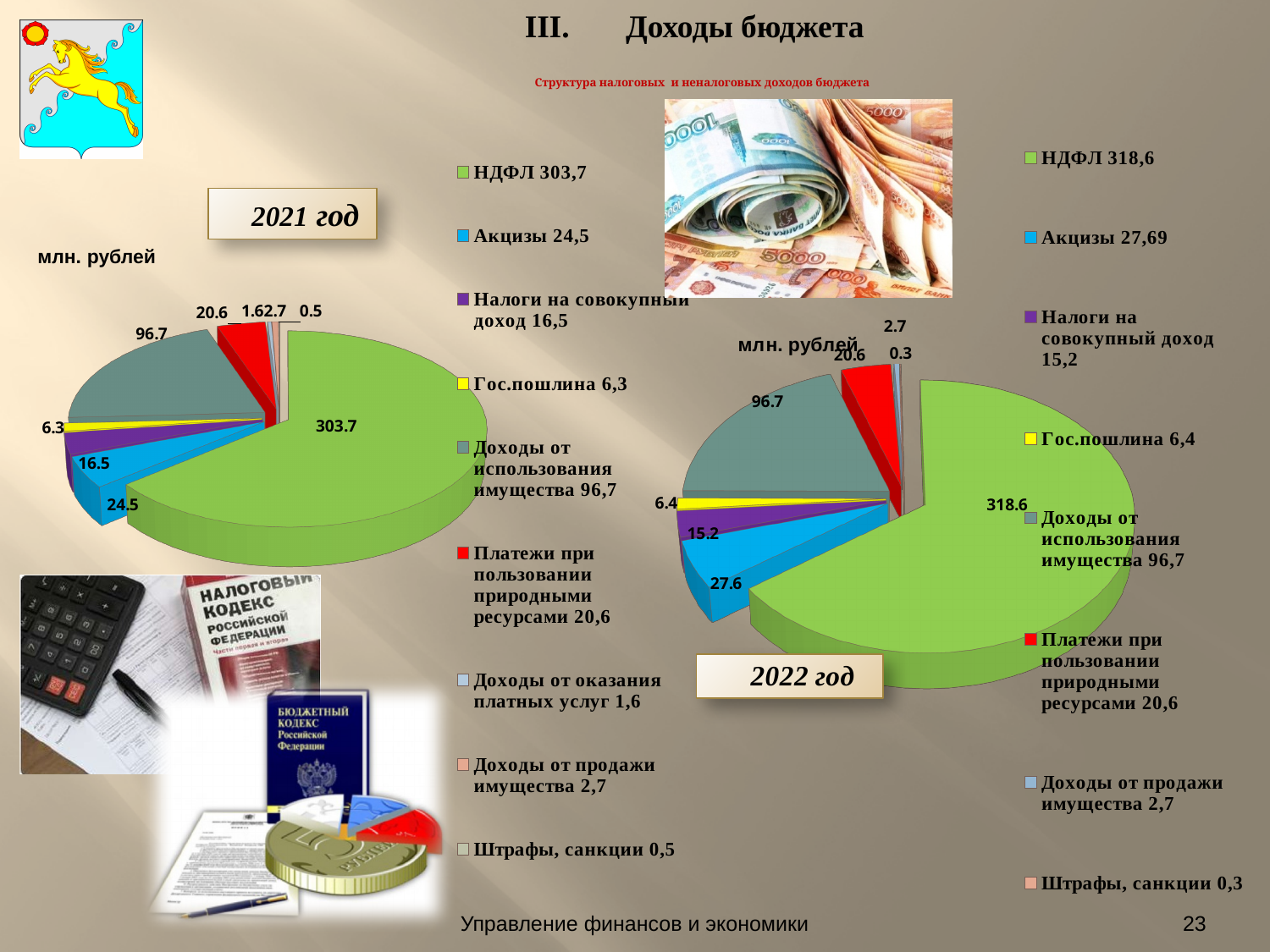
In the 2021 год pie chart, what is the difference between НДФЛ and Доходы от использования имущества? 207.0 What type of chart is used for the 2022 год data? Pie chart How much larger is НДФЛ in the 2022 год pie chart than in the 2021 год pie chart? 14.9 In the 2021 год pie chart, what is the value for Доходы от использования имущества? 96.7 In the 2022 год pie chart, what is the value for НДФЛ? 318.6 In the 2021 год pie chart, what is the value for НДФЛ? 303.7 In the 2022 год pie chart, which category has the smallest value? Штрафы, санкции In the 2021 год pie chart, which is larger: Акцизы or Налоги на совокупный доход? Акцизы In the 2021 год pie chart, which category has the largest value? НДФЛ In the 2021 год pie chart, which category has the smallest value? Штрафы, санкции How many categories does the 2021 год pie chart show? 9 In the 2022 год pie chart, what is the value for Налоги на совокупный доход? 15.2